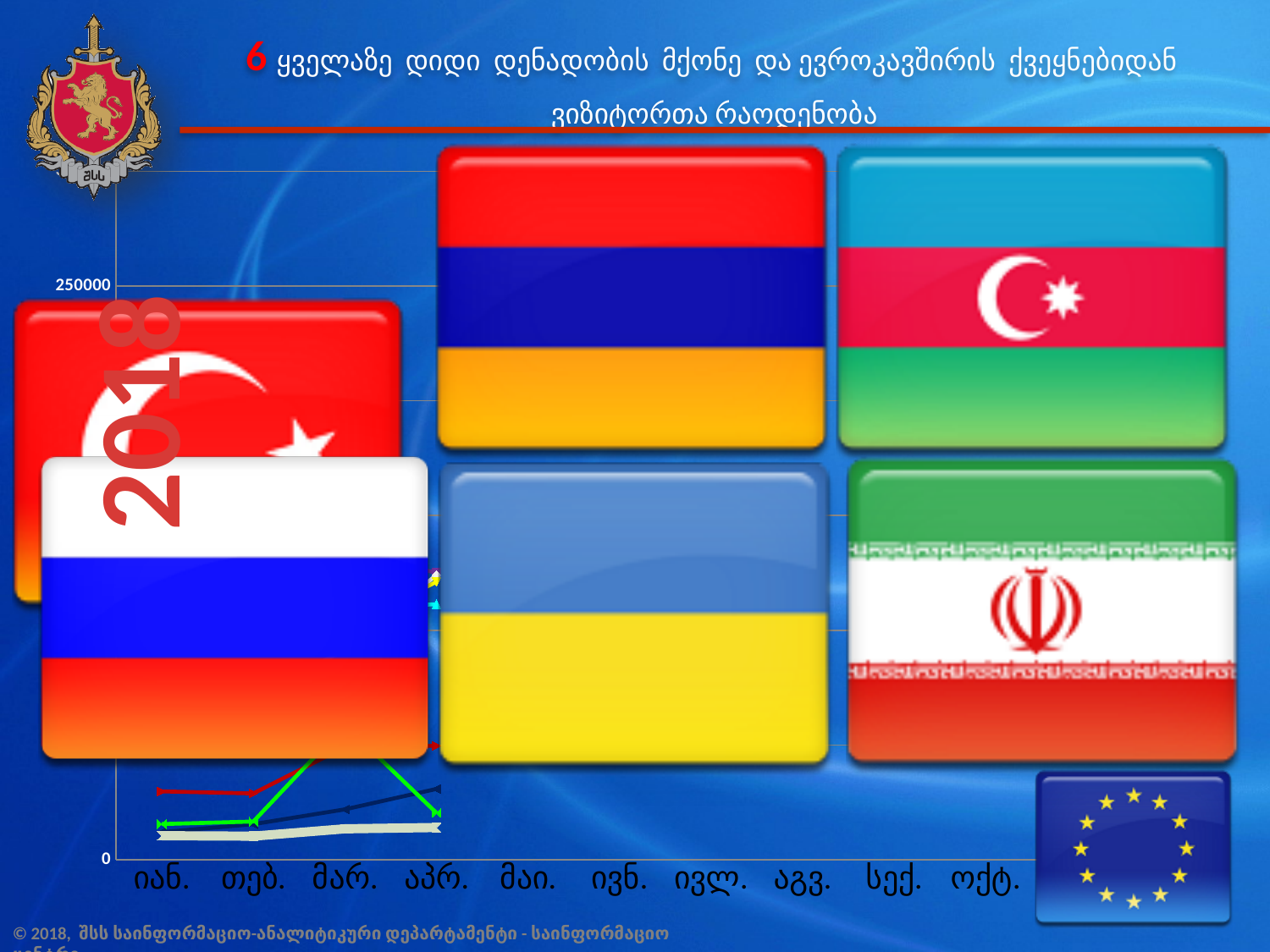
What is the highest value labelled on the y axis of the chart? 250000 What is the first month labelled on the x axis of the chart? იან. Does the green line rise or fall between თებ. and მარ.? rise Does the red line rise or fall between თებ. and მარ.? rise How many month categories are labelled along the x axis of the chart? 10 What is the lowest value labelled on the y axis of the chart? 0 What is the last month labelled on the x axis of the chart? ოქტ. What kind of chart is shown on the slide? line chart